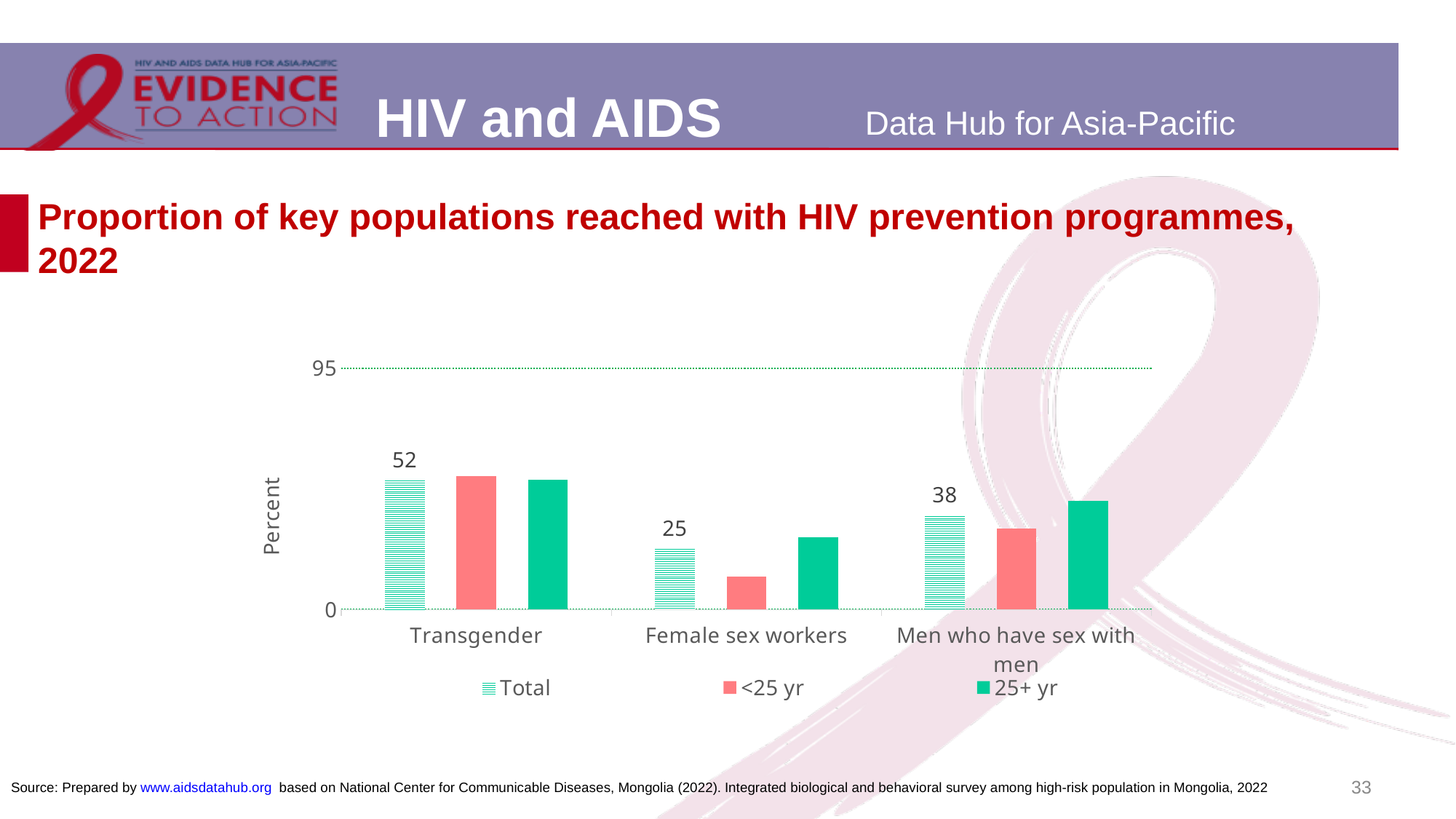
How many series does the legend list? 3 What is the difference between the Total values for Men who have sex with men and Female sex workers? 13 What is the Total value for Men who have sex with men? 38 Which is larger: the Total value for Transgender or for Men who have sex with men? Transgender Which key population has the highest Total proportion reached? Transgender For Female sex workers, which is larger: the <25 yr bar or the 25+ yr bar? 25+ yr How many key population categories are shown on the x axis? 3 What is the Total value for Female sex workers? 25 What is the difference between the Total values for Transgender and Female sex workers? 27 What is the Total value for Transgender? 52 Which key population has the lowest Total proportion reached? Female sex workers What kind of chart is shown on the slide? Bar chart